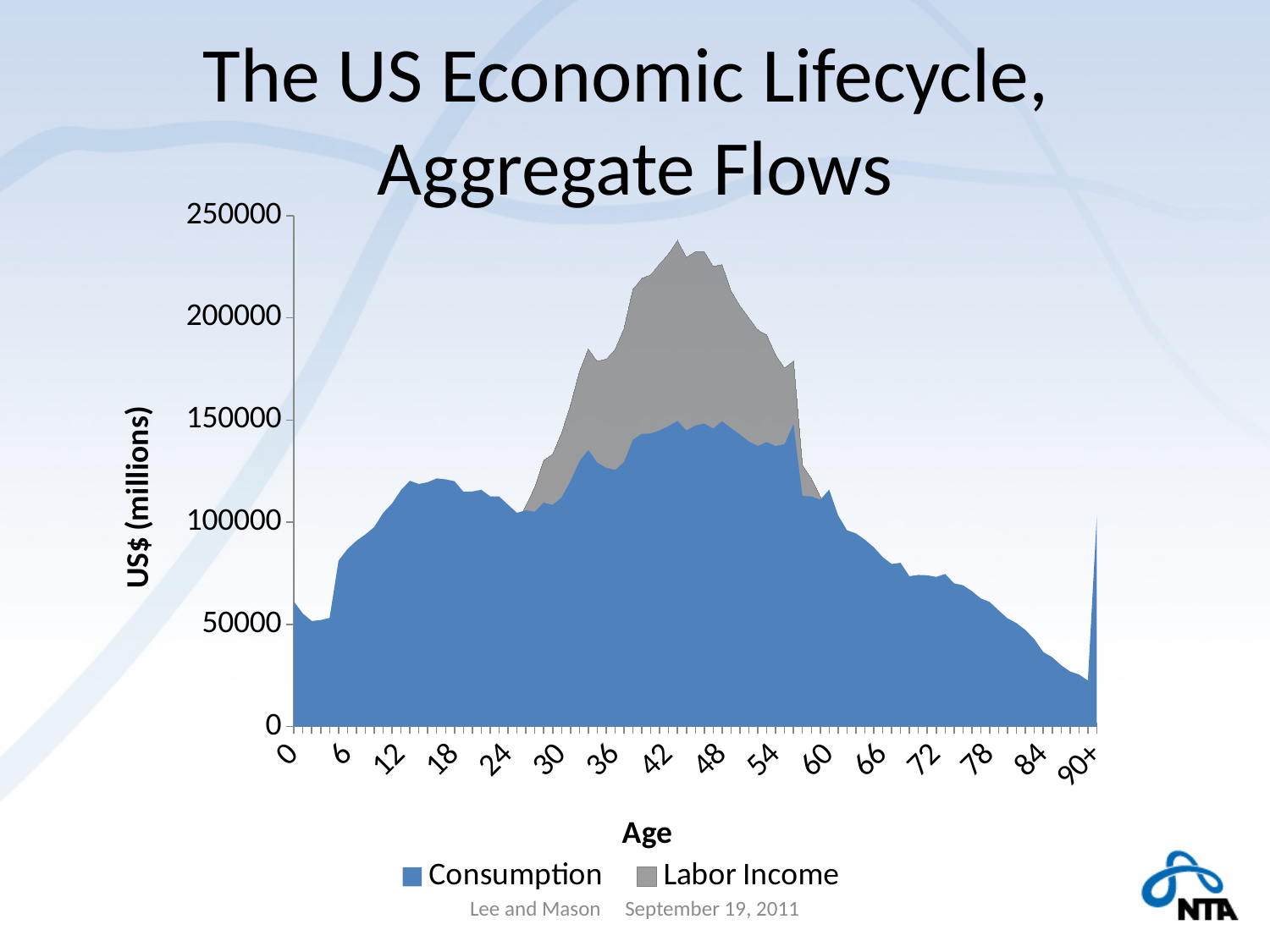
Is the Consumption value at age 42 greater or less than 200000? less Is the Consumption value at age 6 greater or less than 100000? less Is the Consumption value at age 12 greater or less than 100000? greater What is the title of the chart? The US Economic Lifecycle, Aggregate Flows How many series does the legend list? 2 Which colour represents Consumption in the chart? Blue Does Consumption rise or fall between age 6 and age 12? Rise Does Consumption rise or fall between age 60 and age 84? Fall What kind of chart is shown on the slide? Area chart